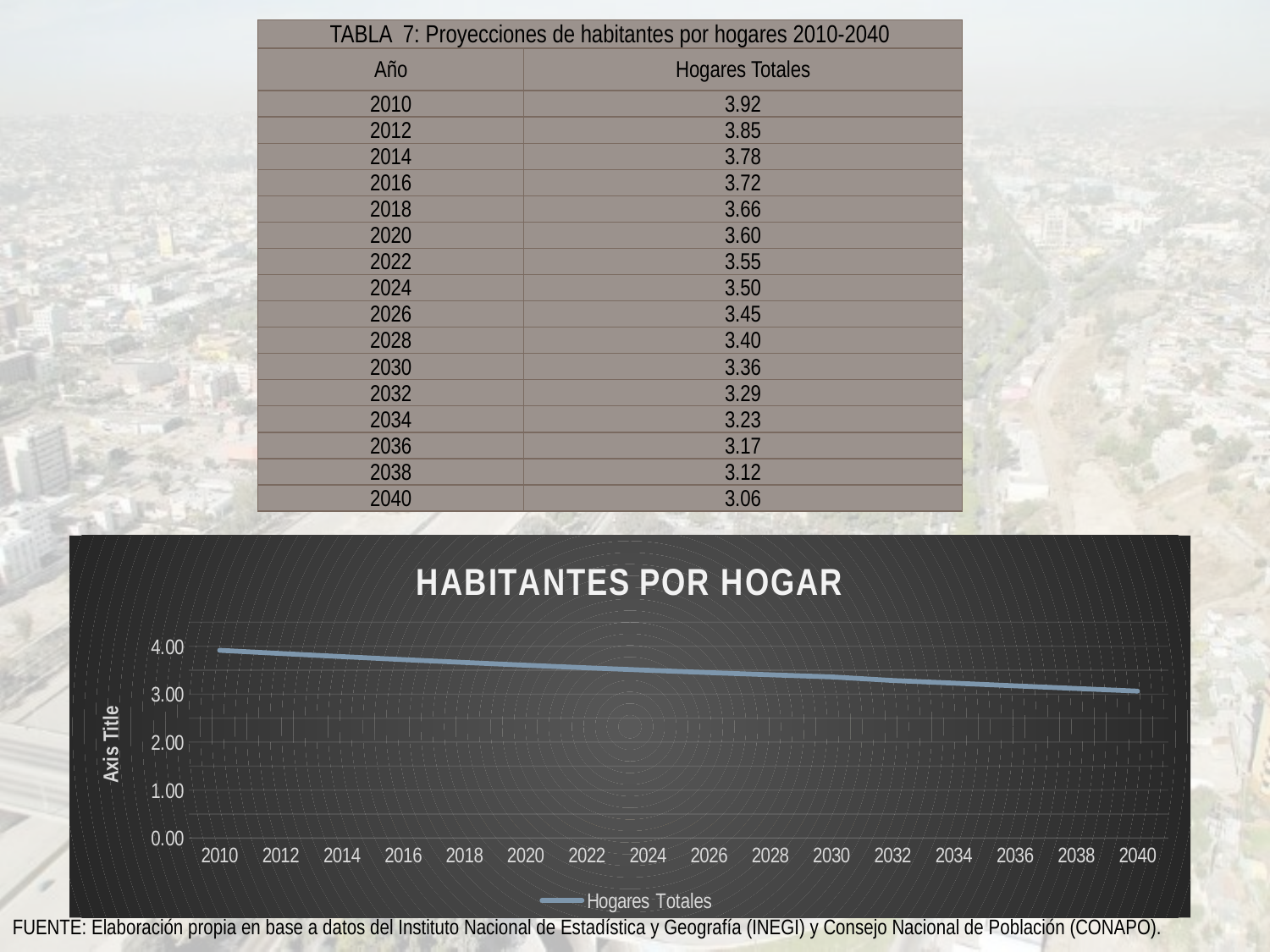
Do the values in the HABITANTES POR HOGAR chart rise or fall from 2010 to 2040? fall What is the name of the series shown in the legend of the HABITANTES POR HOGAR chart? Hogares Totales Which year has the lowest value in the HABITANTES POR HOGAR chart? 2040 What is the value of Hogares Totales for 2040 according to the slide? 3.06 What is the difference between the Hogares Totales values for 2010 and 2040 shown on the slide? 0.86 Which year has the highest value in the HABITANTES POR HOGAR chart? 2010 How many series does the legend of the HABITANTES POR HOGAR chart list? 1 What is the value of Hogares Totales for 2010 according to the slide? 3.92 In the HABITANTES POR HOGAR chart, is the value for 2010 greater or less than 3.00? greater How many years are plotted along the x axis of the HABITANTES POR HOGAR chart? 16 In the HABITANTES POR HOGAR chart, is the value for 2040 greater or less than 4.00? less What kind of chart is shown under the title HABITANTES POR HOGAR? line chart